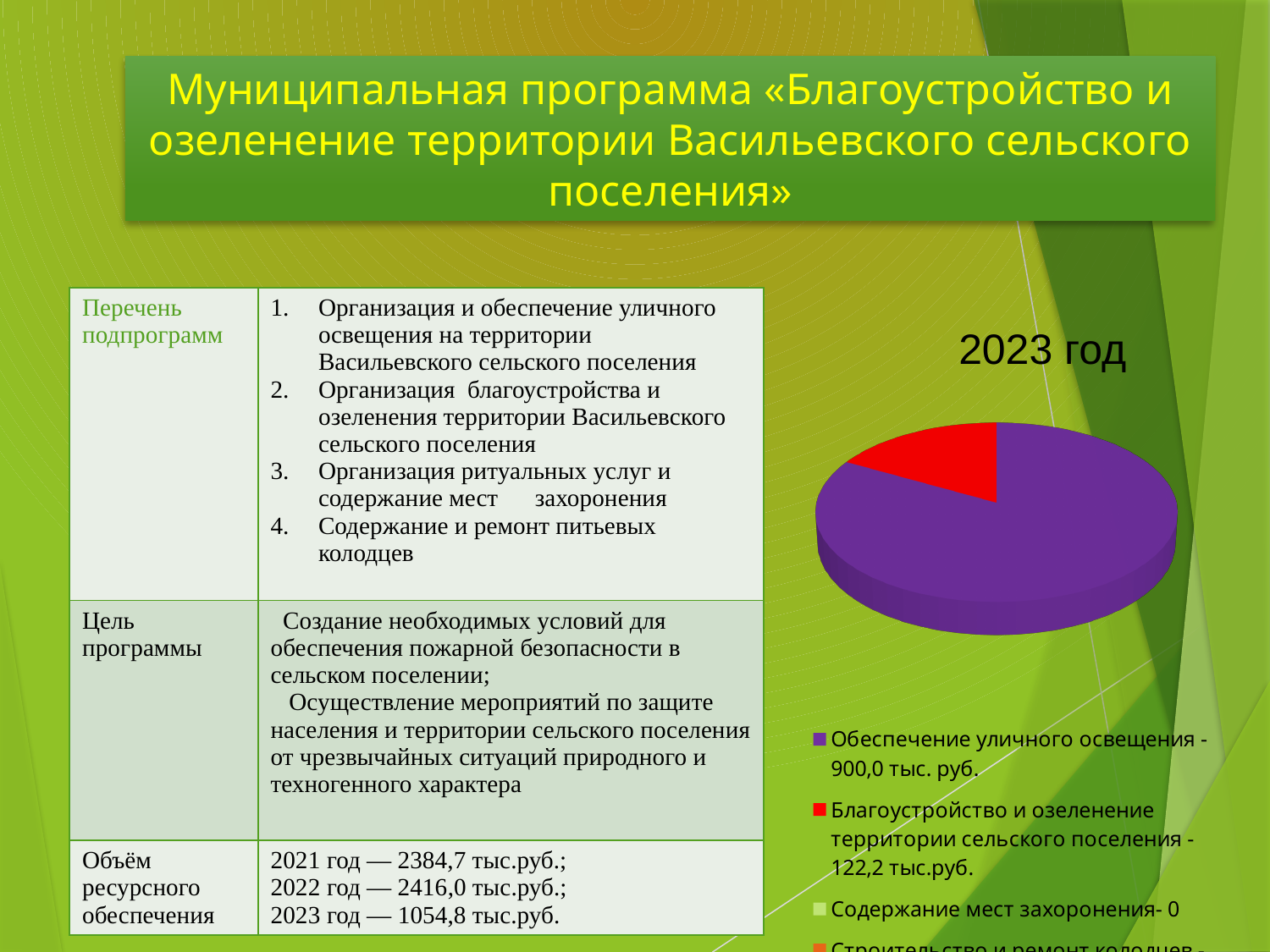
How many entries does the legend of the pie chart list? 4 What is the title of the pie chart? 2023 год What value does the legend give for Обеспечение уличного освещения? 900,0 тыс. руб. Which is larger: Обеспечение уличного освещения or Благоустройство и озеленение территории сельского поселения? Обеспечение уличного освещения Which colour represents Обеспечение уличного освещения in the pie chart? purple What is the difference between the values for Обеспечение уличного освещения and Благоустройство и озеленение территории сельского поселения? 777,8 тыс. руб. What value does the legend give for Благоустройство и озеленение территории сельского поселения? 122,2 тыс.руб. What kind of chart is shown on the slide? pie chart What value does the legend give for Содержание мест захоронения? 0 Which category has the largest slice of the pie? Обеспечение уличного освещения